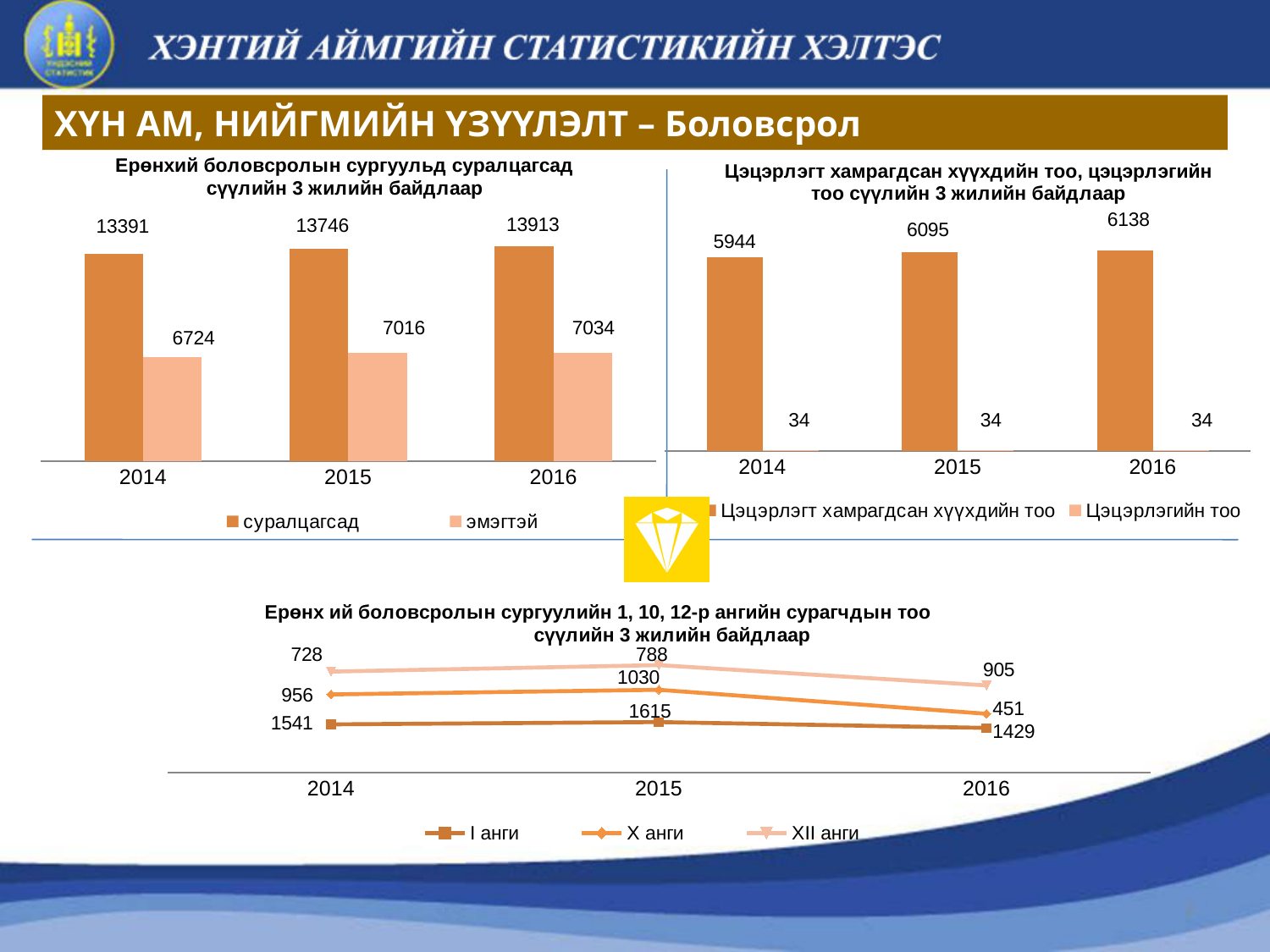
What kind of chart is the bottom chart (Ерөнхий боловсролын сургуулийн 1, 10, 12-р ангийн сурагчдын тоо)? line chart In the top-right chart (Цэцэрлэгт хамрагдсан хүүхдийн тоо), how many series does the legend list? 2 In the top-right chart (Цэцэрлэгт хамрагдсан хүүхдийн тоо), which year has the highest number of children enrolled in kindergarten? 2016 In the top-right chart (Цэцэрлэгт хамрагдсан хүүхдийн тоо), what is the value for Цэцэрлэгийн тоо in 2016? 34 In the bottom chart (Ерөнхий боловсролын сургуулийн 1, 10, 12-р ангийн сурагчдын тоо), what is the value for I анги in 2015? 1615 In the bottom chart (Ерөнхий боловсролын сургуулийн 1, 10, 12-р ангийн сурагчдын тоо), what is the value for XII анги in 2016? 905 In the top-left chart (Ерөнхий боловсролын сургуульд суралцагсад), what is the value for эмэгтэй in 2014? 6724 In the top-left chart (Ерөнхий боловсролын сургуульд суралцагсад), what is the difference between суралцагсад and эмэгтэй in 2015? 6730 In the top-left chart (Ерөнхий боловсролын сургуульд суралцагсад), what is the value for суралцагсад in 2016? 13913 In the bottom chart (Ерөнхий боловсролын сургуулийн 1, 10, 12-р ангийн сурагчдын тоо), how many series does the legend list? 3 In the top-left chart (Ерөнхий боловсролын сургуульд суралцагсад), do the суралцагсад values rise or fall from 2014 to 2016? rise In the top-right chart (Цэцэрлэгт хамрагдсан хүүхдийн тоо), what is the number of children enrolled in kindergarten in 2015? 6095